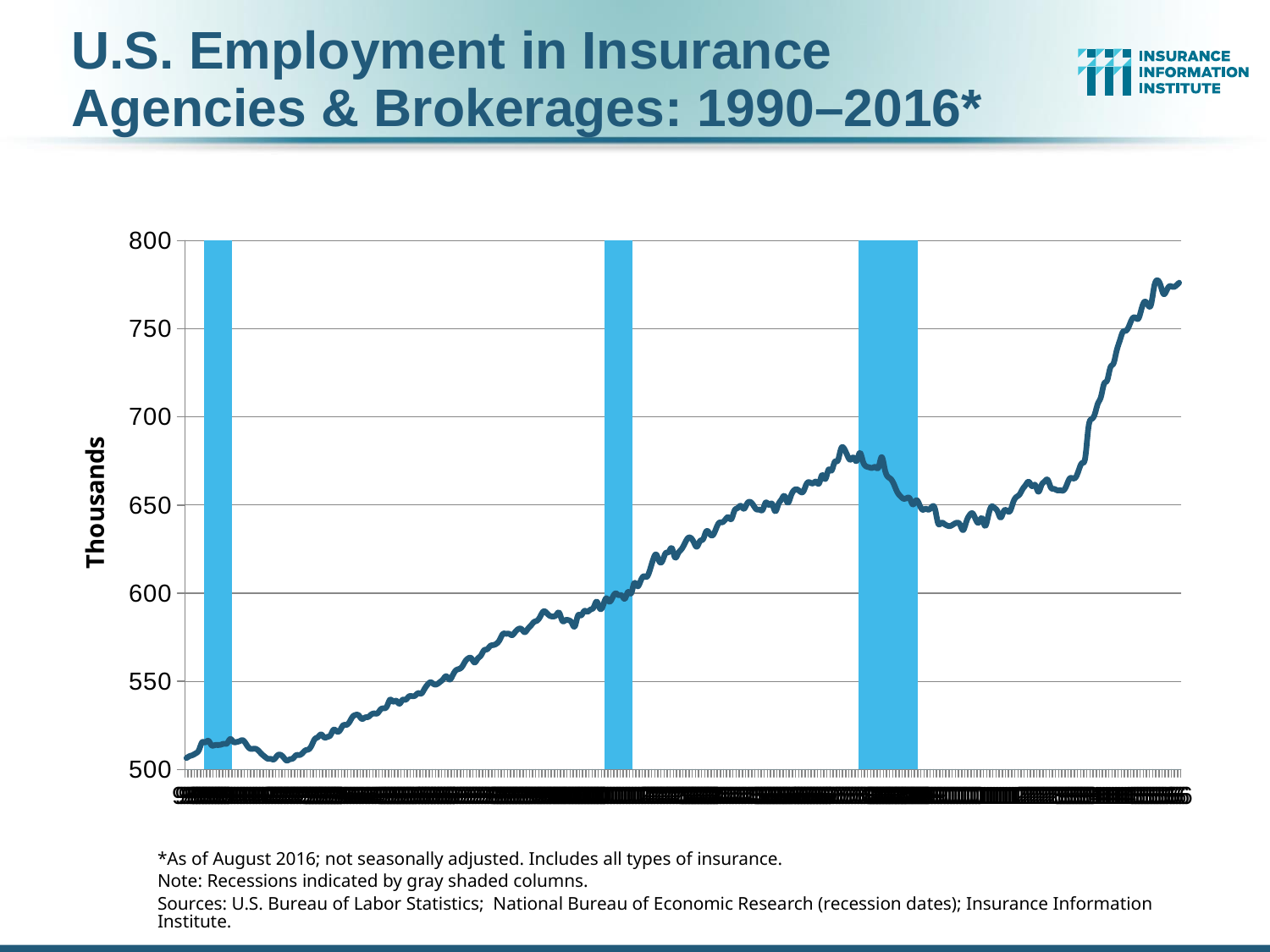
Is the value at the right end of the line (the most recent point) greater or less than 700? greater Overall, does the employment line rise or fall from the left end of the chart to the right end? Rises How many shaded recession columns are shown on the chart? 3 Is the lowest point on the employment line greater or less than 550? less Is the value at the right end of the line greater or less than the value at the left end of the line? greater What kind of chart is shown on the slide? Line chart Is the highest point on the employment line greater or less than 750? greater What is the highest value shown on the vertical axis of the chart? 800 Does the employment line rise or fall during the third (rightmost) shaded recession column? Falls What is the label on the vertical axis of the chart? Thousands What is the title of the chart on the slide? U.S. Employment in Insurance Agencies & Brokerages: 1990–2016*